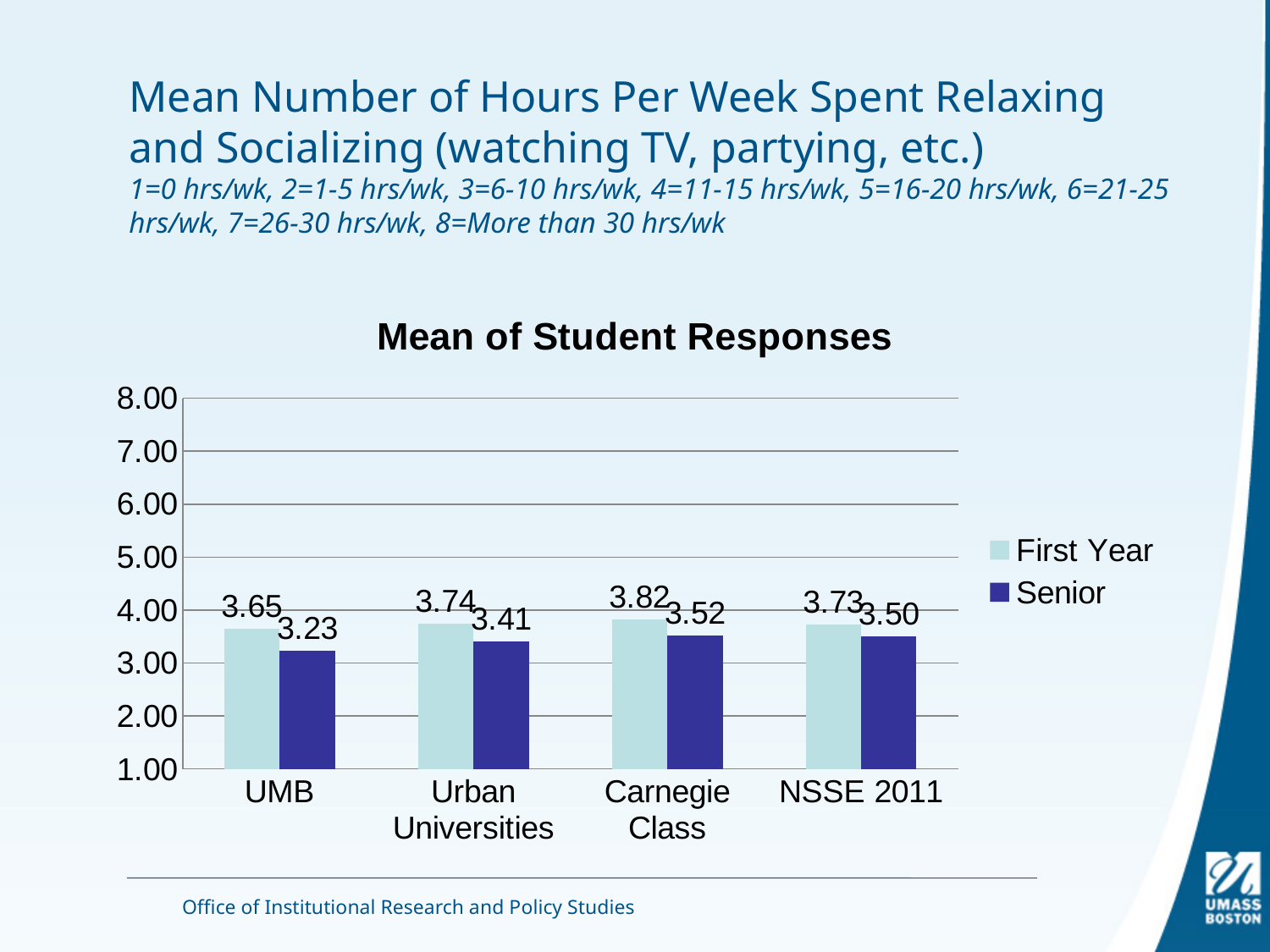
Is the First Year value for Carnegie Class greater or less than 4.00? less Which category has the highest First Year value? Carnegie Class Which category has the lowest Senior value? UMB What is the title of the chart? Mean of Student Responses What is the difference between the First Year and Senior values for UMB? 0.42 Which is larger, the Senior value for Urban Universities or the Senior value for NSSE 2011? NSSE 2011 How many categories are shown on the x axis? 4 What kind of chart is shown? bar chart What is the Senior value for Carnegie Class? 3.52 How many series does the legend list? 2 What is the First Year value for UMB? 3.65 What is the Senior value for NSSE 2011? 3.50